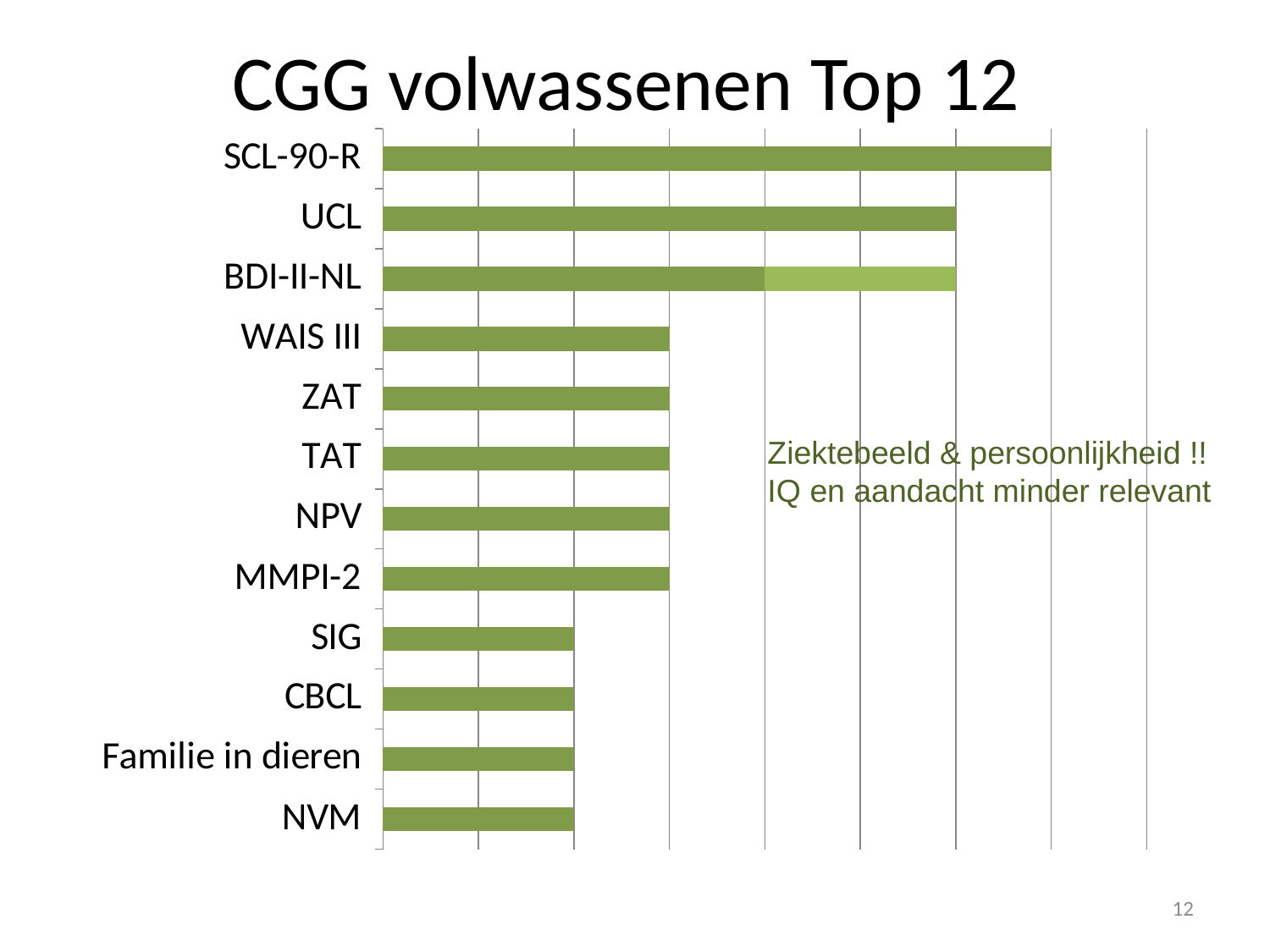
Which category's bar is drawn in two different shades of green? BDI-II-NL Which bar is longer, SCL-90-R or BDI-II-NL? SCL-90-R How many categories (instruments) are plotted in the chart? 12 Which bar is longer, UCL or WAIS III? UCL What type of chart is shown on the slide? bar chart Which category has the longest bar in the chart? SCL-90-R Which bar is longer, MMPI-2 or NVM? MMPI-2 What is the title of the chart? CGG volwassenen Top 12 Which category is listed at the bottom of the chart? NVM